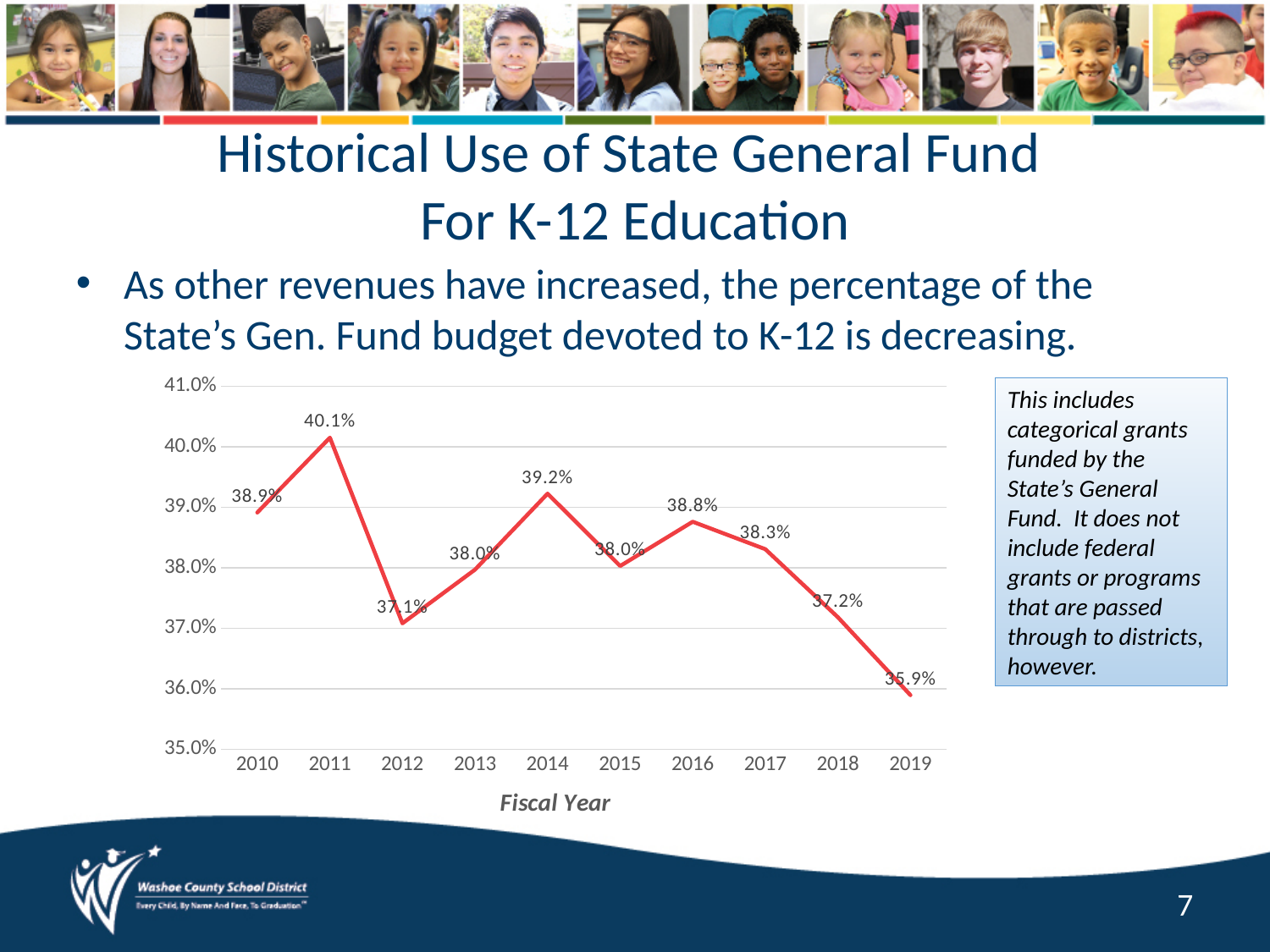
Overall, do the values rise or fall from 2010 to 2019? fall Which fiscal year has the lowest value? 2019 How many fiscal years are plotted on the chart? 10 What is the label of the x axis? Fiscal Year Which is larger, the value for 2016 or the value for 2017? 2016 What is the value for fiscal year 2019? 35.9% What type of chart is shown on the slide? line chart Which fiscal year has the highest value? 2011 What is the value for fiscal year 2014? 39.2% What is the difference between the values for 2011 and 2019? 4.2% What is the value for fiscal year 2011? 40.1% Is the value for 2012 greater or less than 38.0%? less